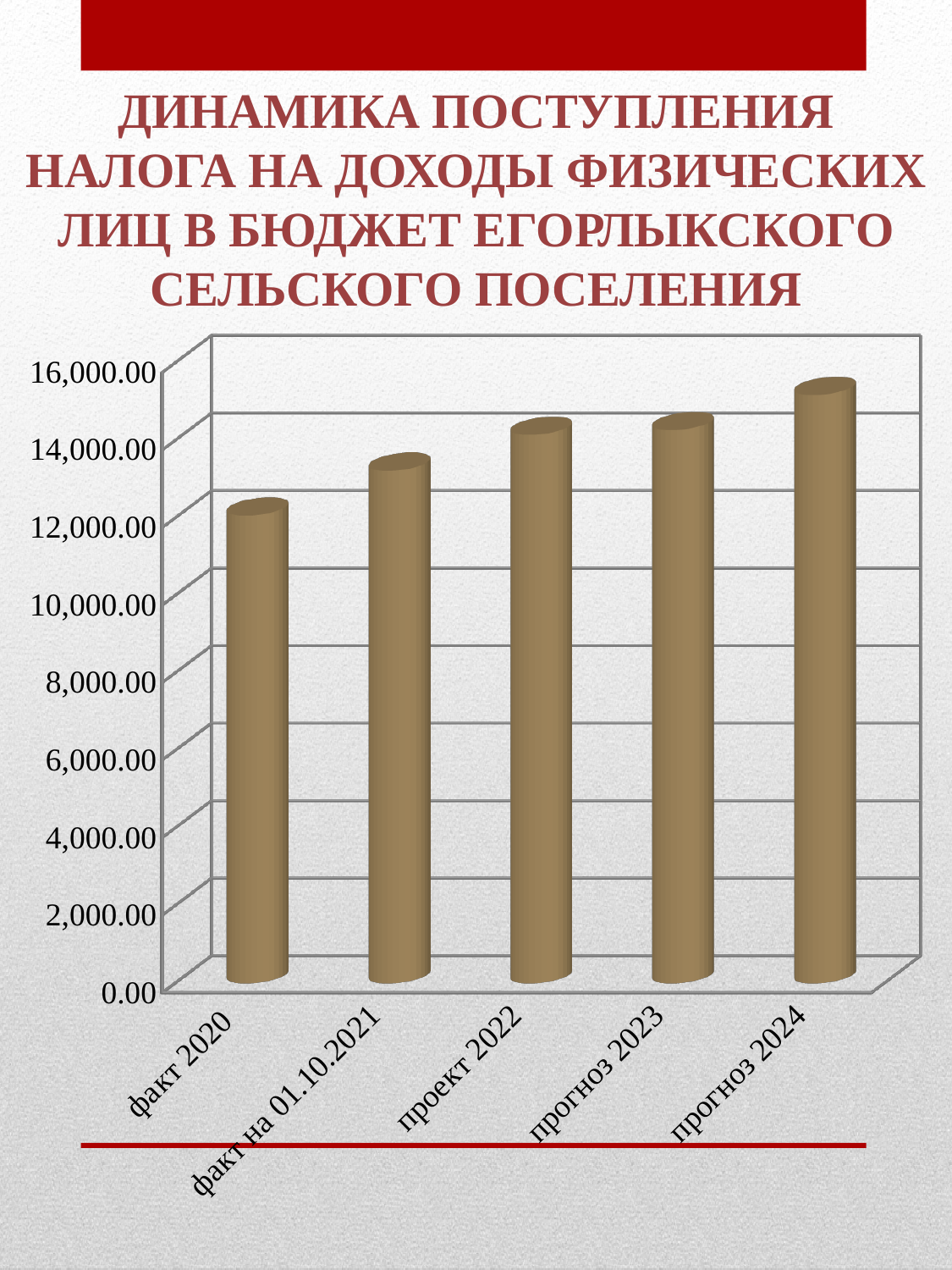
Is the value for прогноз 2024 greater or less than 16,000.00? less Which category has the lowest value in the chart? факт 2020 Is the value for факт на 01.10.2021 greater or less than 14,000.00? less Is the value for факт 2020 greater or less than 14,000.00? less What is the label of the first category on the x axis? факт 2020 What kind of chart is shown on the slide? bar chart Do the values rise or fall from факт 2020 to прогноз 2024 along the x axis? rise How many categories are plotted on the x axis of the chart? 5 Which is larger, the value for прогноз 2024 or the value for факт 2020? прогноз 2024 Which category has the highest value in the chart? прогноз 2024